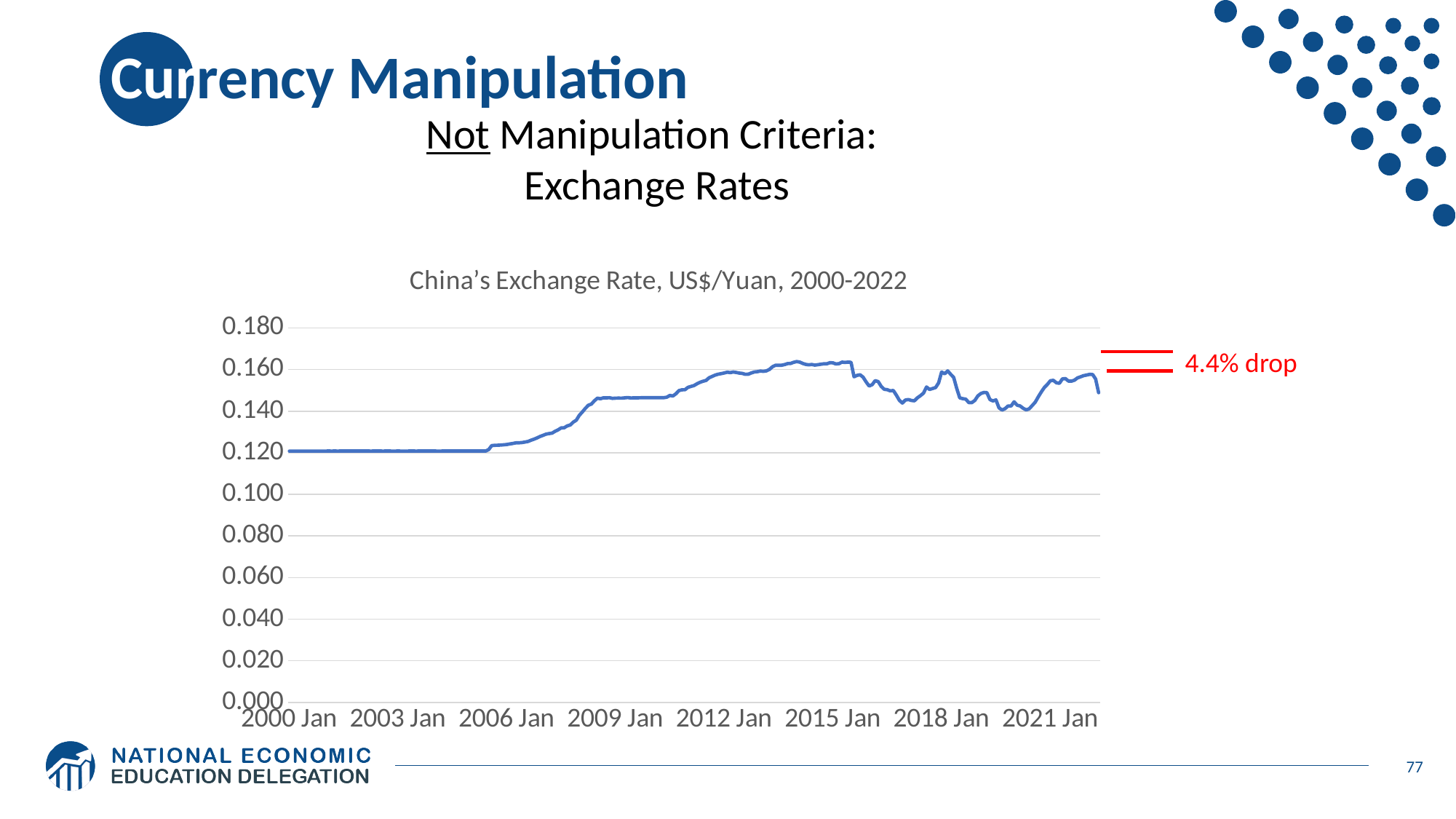
Between 2015 Jan and 2018 Jan, does the exchange rate rise or fall? fall How many year labels are shown on the x axis? 8 Which is higher, the exchange rate at 2012 Jan or at 2003 Jan? 2012 Jan What is the title of the chart? China's Exchange Rate, US$/Yuan, 2000-2022 What type of chart is shown on the slide? line chart Between 2006 Jan and 2009 Jan, does the exchange rate rise or fall? rise Is the exchange rate value at 2000 Jan greater or less than 0.100? greater What does the red annotation next to the end of the line say? 4.4% drop Is the exchange rate value at 2021 Jan greater or less than 0.140? greater Is the exchange rate value at 2015 Jan greater or less than 0.140? greater